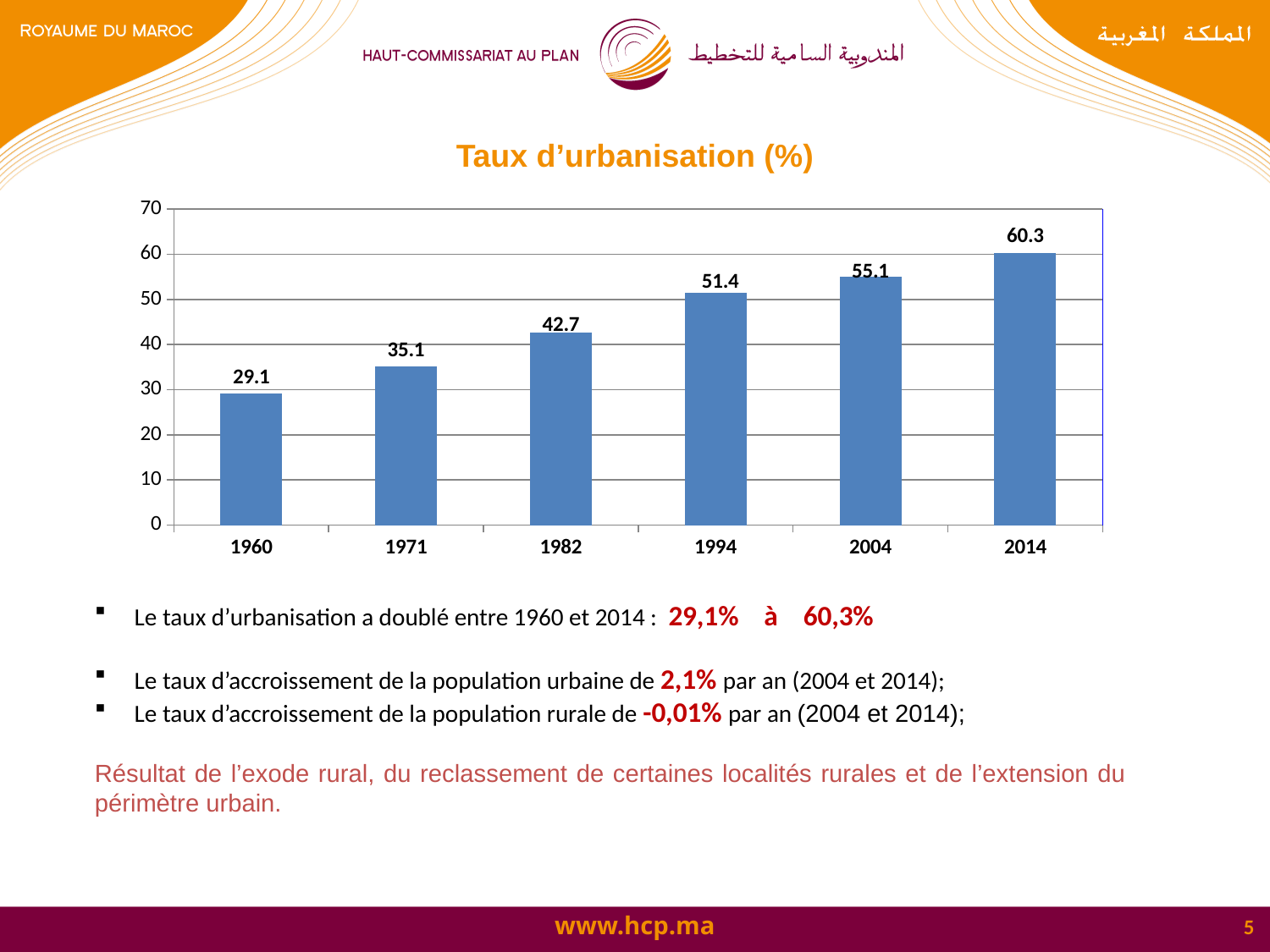
What is the difference between the urbanisation rates for 2014 and 1960? 31.2 Do the urbanisation rates rise or fall from 1960 to 2014? rise What is the difference between the urbanisation rates for 2004 and 1994? 3.7 Which year has the highest urbanisation rate? 2014 What is the urbanisation rate shown for 1994? 51.4 What kind of chart is shown on the slide? bar chart Which is larger, the urbanisation rate for 1982 or for 1971? 1982 Which year has the lowest urbanisation rate? 1960 Is the value for 1982 greater or less than 40? greater What is the urbanisation rate shown for 1960? 29.1 What is the urbanisation rate shown for 2014? 60.3 How many years are shown on the x axis of the chart? 6